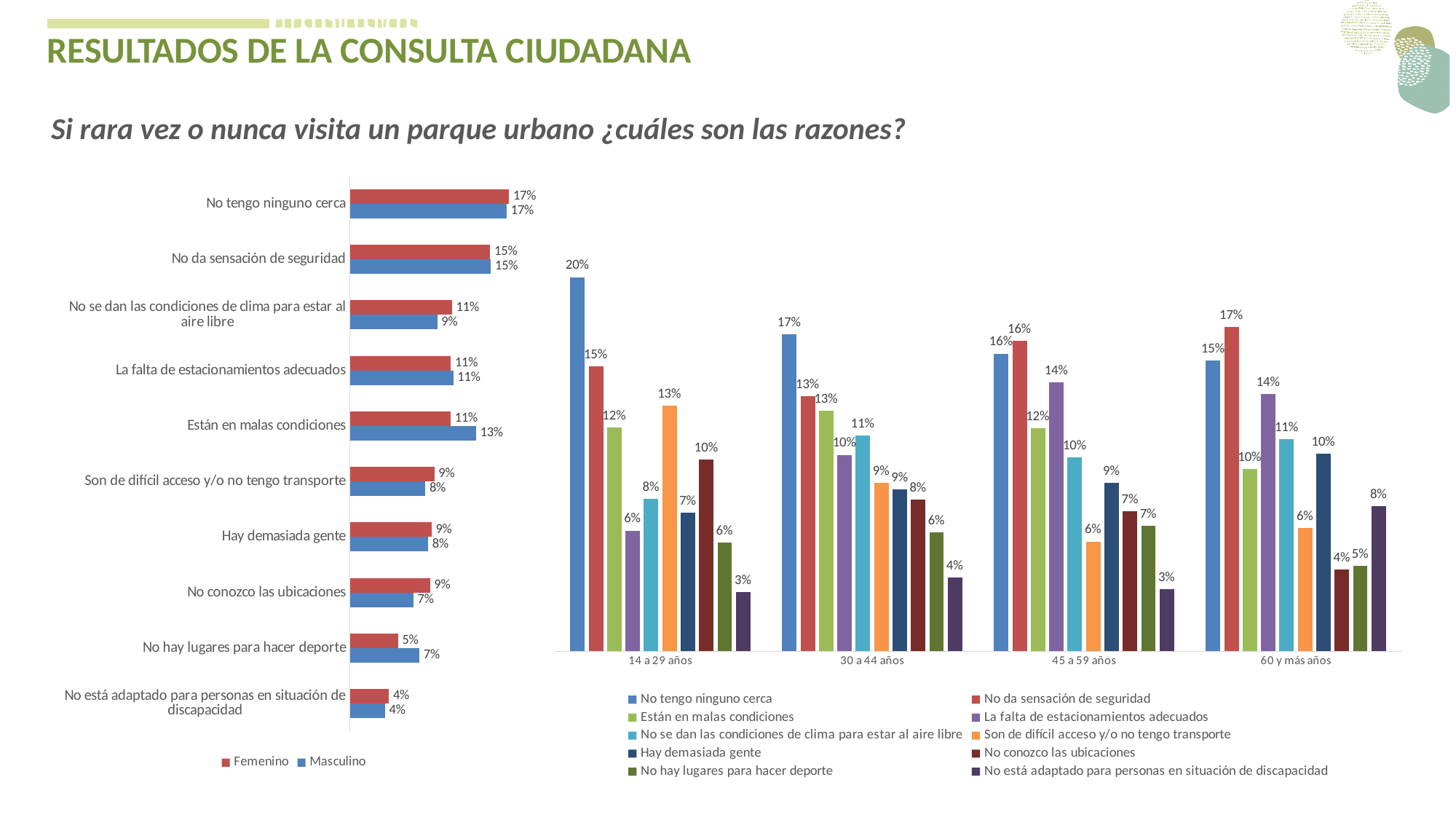
In the left chart (by gender), which is larger for 'No conozco las ubicaciones': Femenino or Masculino? Femenino In the left chart (by gender), what is the Masculino value for 'No hay lugares para hacer deporte'? 7% In the left chart (by gender), what is the Femenino value for 'No se dan las condiciones de clima para estar al aire libre'? 11% In the left chart (by gender), which reason has the highest Femenino value? No tengo ninguno cerca In the right chart (by age group), what is the value for 'No tengo ninguno cerca' in the 14 a 29 años group? 20% What type of chart is the right chart (by age group)? Bar chart In the left chart (by gender), how many reasons (categories) are listed? 10 In the right chart (by age group), which reason has the highest value in the 60 y más años group? No da sensación de seguridad In the left chart (by gender), how many series does the legend list? 2 In the left chart (by gender), what is the difference between the Masculino and Femenino values for 'Están en malas condiciones'? 2% In the right chart (by age group), how many series does the legend list? 10 In the right chart (by age group), what is the value for 'No está adaptado para personas en situación de discapacidad' in the 60 y más años group? 8%